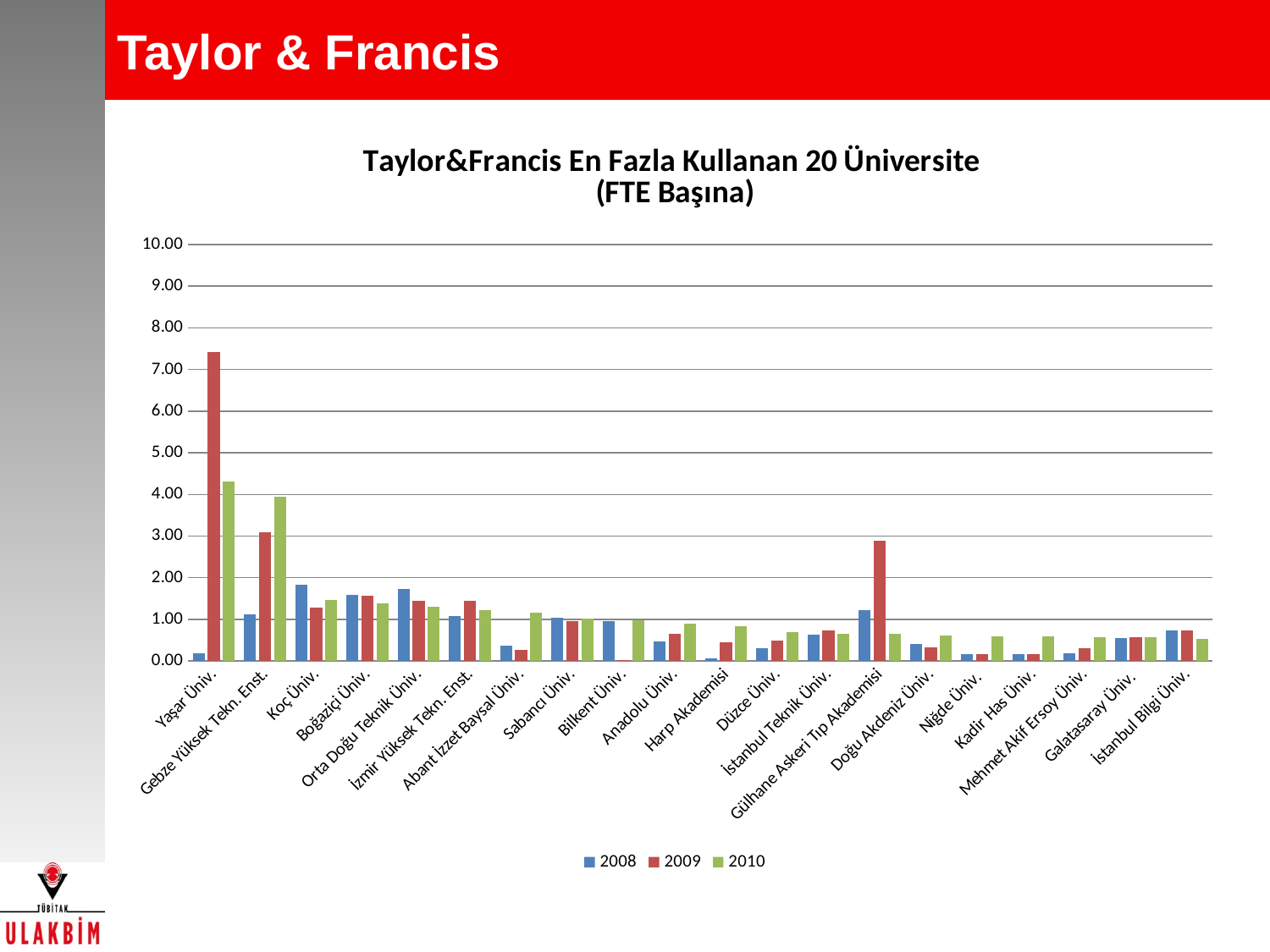
Which university has the highest 2009 value? Yaşar Üniv. How many series does the chart's legend list? 3 Is the 2009 value for Yaşar Üniv. greater or less than 7.00? greater What is the title of the chart? Taylor&Francis En Fazla Kullanan 20 Üniversite (FTE Başına) Which is larger, the 2009 value for Yaşar Üniv. or the 2009 value for Gebze Yüksek Tekn. Enst.? Yaşar Üniv. What kind of chart is shown on the slide? Bar chart Is the 2009 value for Gülhane Askeri Tıp Akademisi greater or less than 2.00? greater Which university has the highest 2010 value? Yaşar Üniv. Which years are listed in the chart's legend? 2008, 2009, 2010 How many universities are shown on the x axis of the chart? 20 Is the 2008 value for Yaşar Üniv. greater or less than 1.00? less